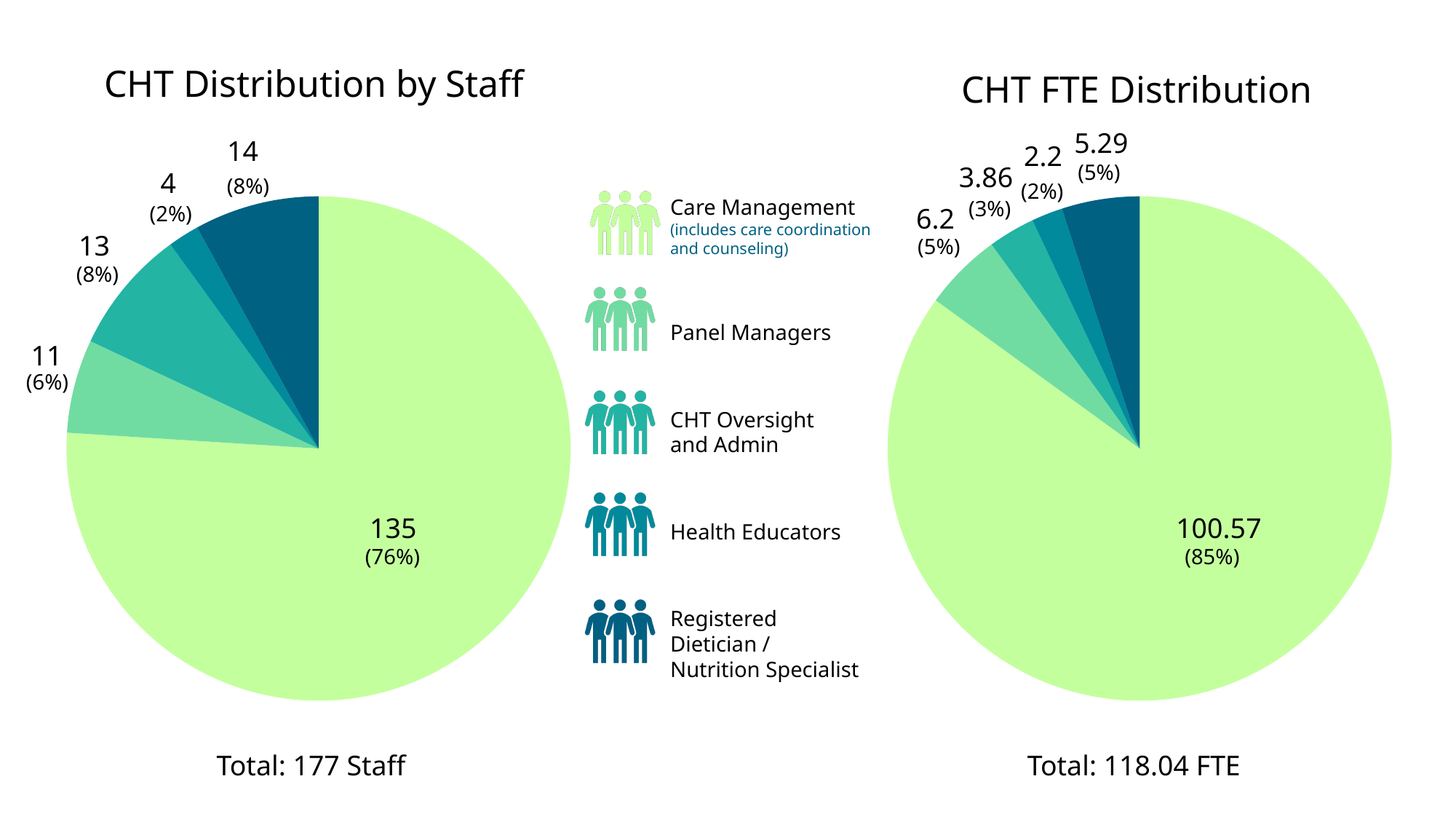
In the CHT Distribution by Staff chart, what share of staff are Registered Dietician / Nutrition Specialists? 8% In the CHT FTE Distribution chart, what share of FTE is Care Management? 85% In the CHT Distribution by Staff chart, how many staff are in Care Management? 135 In the CHT Distribution by Staff chart, what is the difference between the number of Care Management staff and Panel Managers? 124 In the CHT Distribution by Staff chart, what is the total number of staff shown? 177 Staff In the CHT FTE Distribution chart, which category has the lowest FTE? Health Educators In the CHT FTE Distribution chart, what is the FTE value for Panel Managers? 6.2 In the CHT Distribution by Staff chart, which category has the fewest staff? Health Educators In the CHT FTE Distribution chart, what is the FTE value for Care Management? 100.57 What type of chart is the CHT FTE Distribution chart? Pie chart How many categories does the legend list? 5 In the CHT FTE Distribution chart, which is larger: the FTE for Panel Managers or for CHT Oversight and Admin? Panel Managers